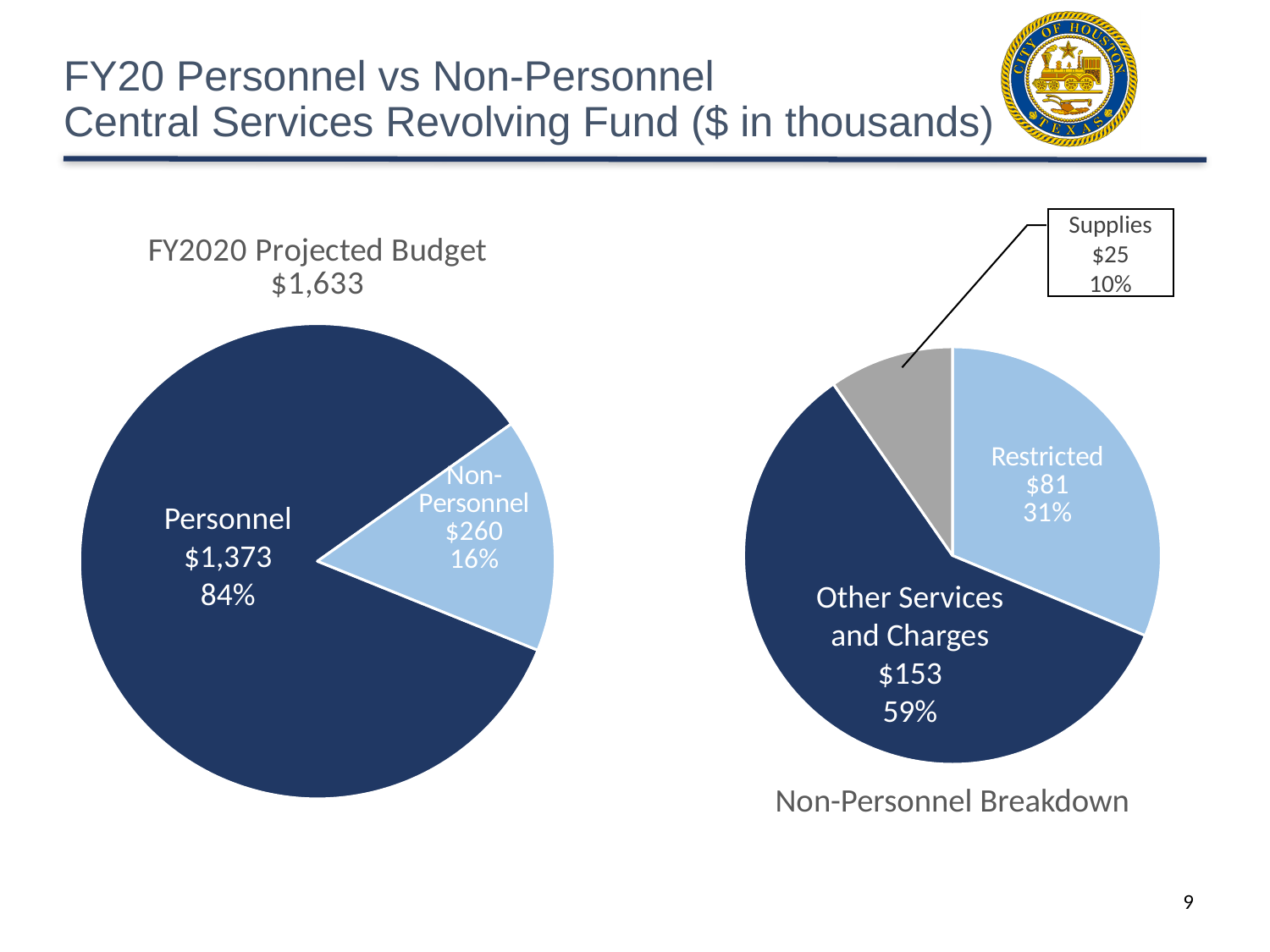
What kind of chart is the FY2020 Projected Budget chart? Pie chart In the Non-Personnel Breakdown chart, how many categories are shown? 3 What total is shown under the FY2020 Projected Budget chart title? $1,633 In the FY2020 Projected Budget chart, what is the value for Personnel? $1,373 In the Non-Personnel Breakdown chart, what is the value for Restricted? $81 In the Non-Personnel Breakdown chart, which category is the smallest? Supplies In the Non-Personnel Breakdown chart, what share of the pie is Supplies? 10% In the Non-Personnel Breakdown chart, what is the difference between Other Services and Charges and Restricted? $72 In the FY2020 Projected Budget chart, how many slices are there? 2 In the Non-Personnel Breakdown chart, which category is the largest? Other Services and Charges In the FY2020 Projected Budget chart, what share of the pie is Non-Personnel? 16% In the FY2020 Projected Budget chart, what is the difference between Personnel and Non-Personnel? $1,113